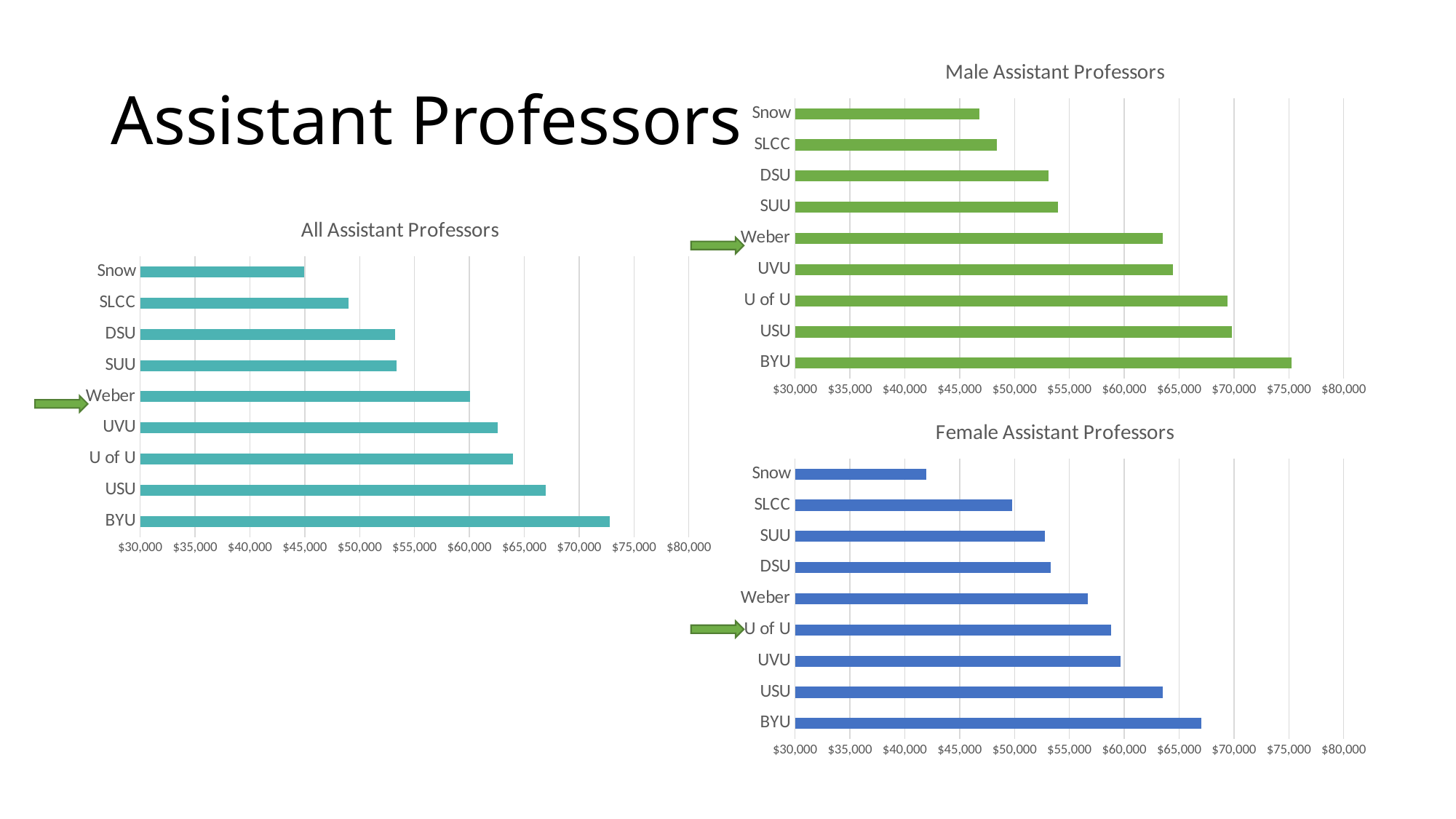
In the 'All Assistant Professors' chart, which institution has the lowest value? Snow In the 'All Assistant Professors' chart, is the value for USU greater or less than $65,000? greater How many institutions are shown in the 'All Assistant Professors' chart? 9 What kind of chart is the 'All Assistant Professors' chart? bar chart In the 'Male Assistant Professors' chart, is the value for Weber greater or less than $60,000? greater In the 'Male Assistant Professors' chart, which institution has the highest value? BYU In the 'Female Assistant Professors' chart, is the value for Snow greater or less than $45,000? less In the 'Female Assistant Professors' chart, which is larger, the value for USU or the value for Weber? USU In the 'Male Assistant Professors' chart, do the bar values rise or fall going from Snow at the top to BYU at the bottom? rise In the 'All Assistant Professors' chart, which institution has the highest value? BYU In the 'Female Assistant Professors' chart, which institution is marked with a green arrow? U of U In the 'Female Assistant Professors' chart, which institution has the lowest value? Snow